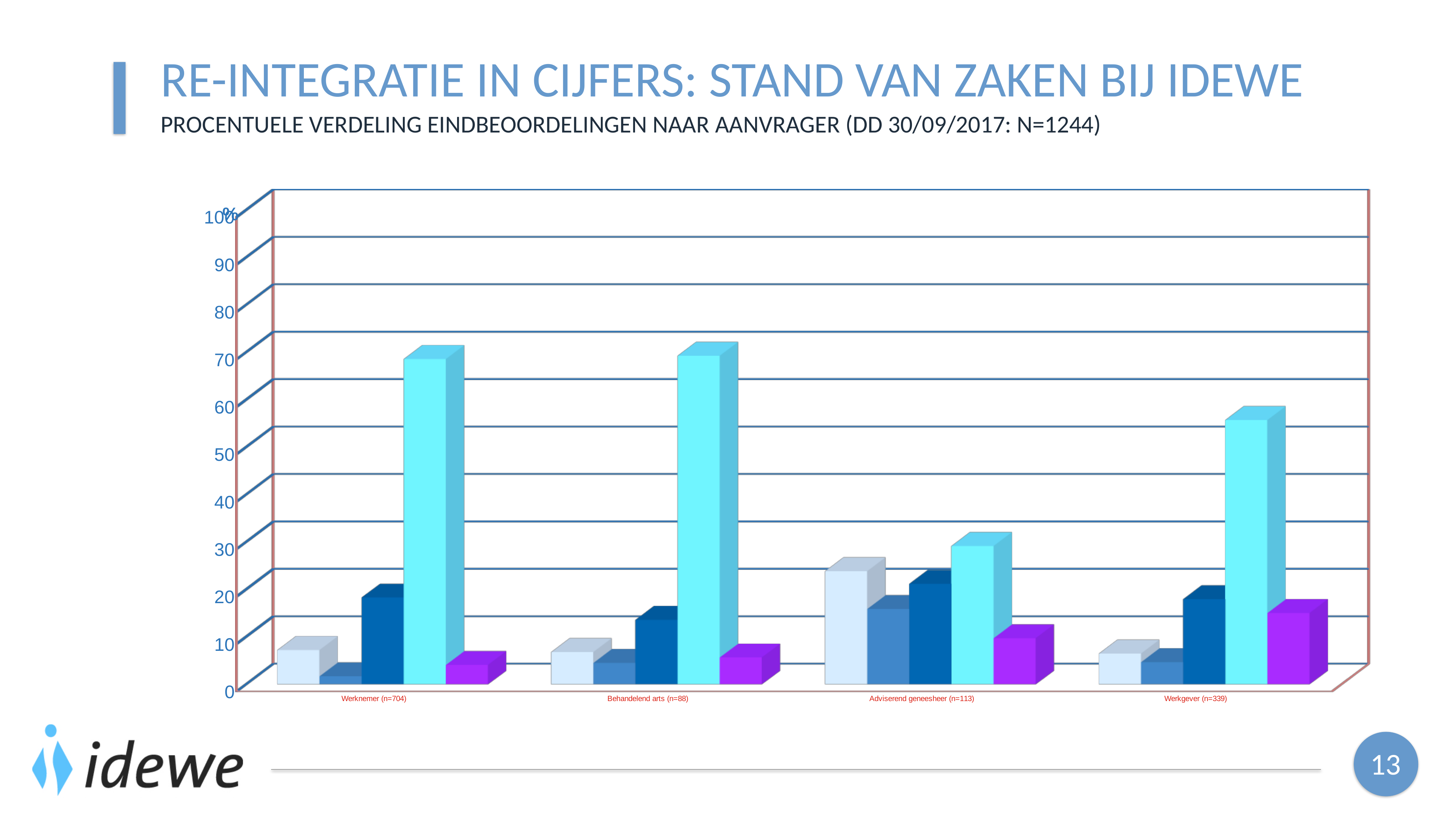
Is the value of the purple bar for Werknemer (n=704) greater or less than 10? less Which is larger: the cyan bar for Werknemer (n=704) or the cyan bar for Adviserend geneesheer (n=113)? Werknemer (n=704) Which category has the tallest light-blue (first) bar? Adviserend geneesheer (n=113) Is the value of the cyan bar for Werkgever (n=339) greater or less than 40? greater How many bars are plotted for each category? 5 Is the value of the tallest (cyan) bar for Werknemer (n=704) greater or less than 60? greater What is the sample size (n) shown for the Behandelend arts category? 88 How many categories (aanvragers) are shown along the x axis? 4 Which is larger: the purple bar for Werkgever (n=339) or the purple bar for Werknemer (n=704)? Werkgever (n=339) Which category has the tallest purple bar? Werkgever (n=339) What kind of chart is shown on the slide? bar chart